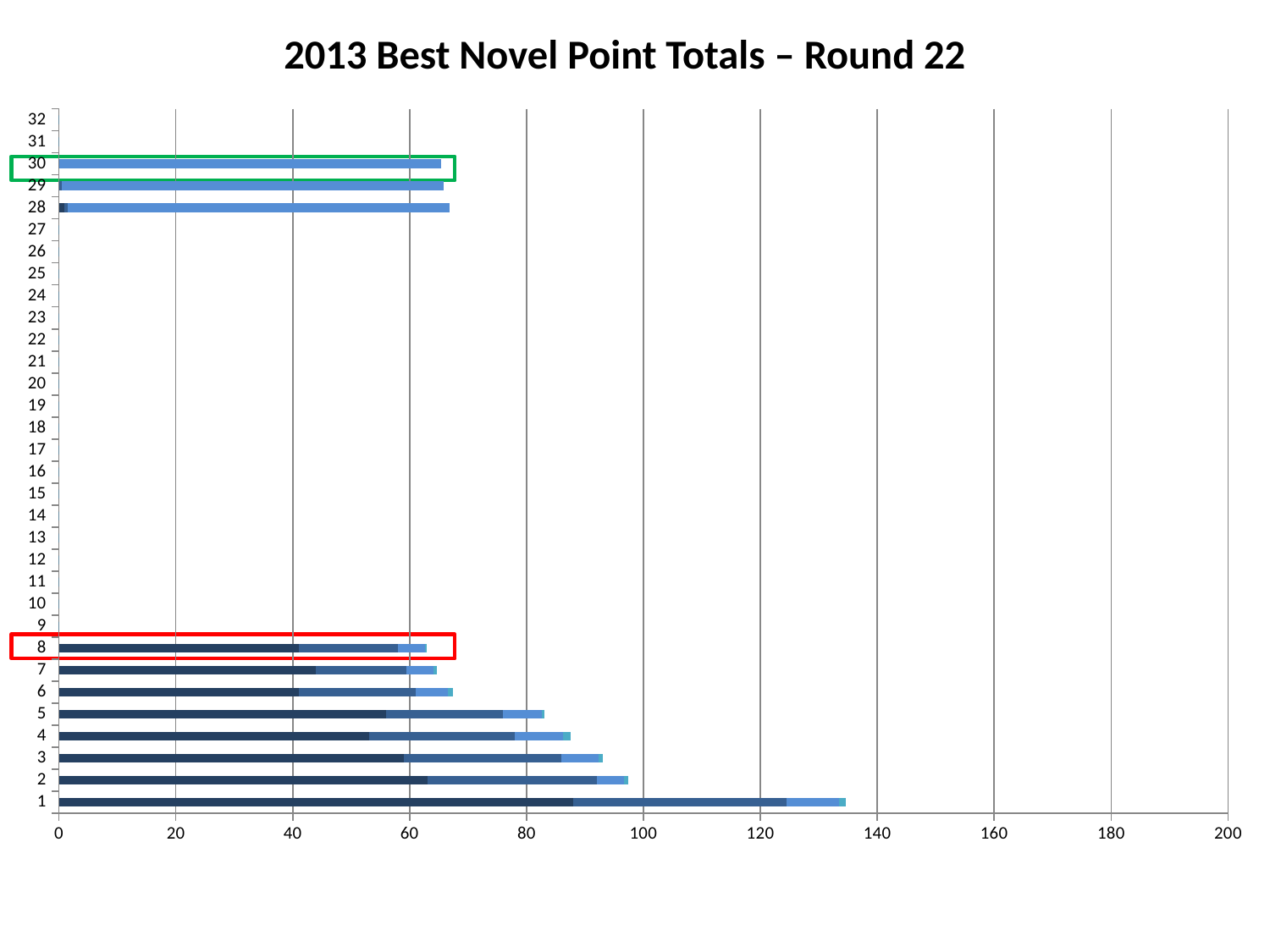
What is the title of the chart? 2013 Best Novel Point Totals – Round 22 How many categories are listed on the vertical axis of the chart? 32 Is the value for category 1 greater or less than 120? greater Which has the larger value, category 1 or category 2? 1 Is the value for category 28 greater or less than 60? greater Is the value for category 6 greater or less than 80? less What kind of chart is shown on the slide? bar chart Which category on the vertical axis is outlined with a red box? 8 Which category has the longest bar in the chart? 1 Which has the larger value, category 5 or category 6? 5